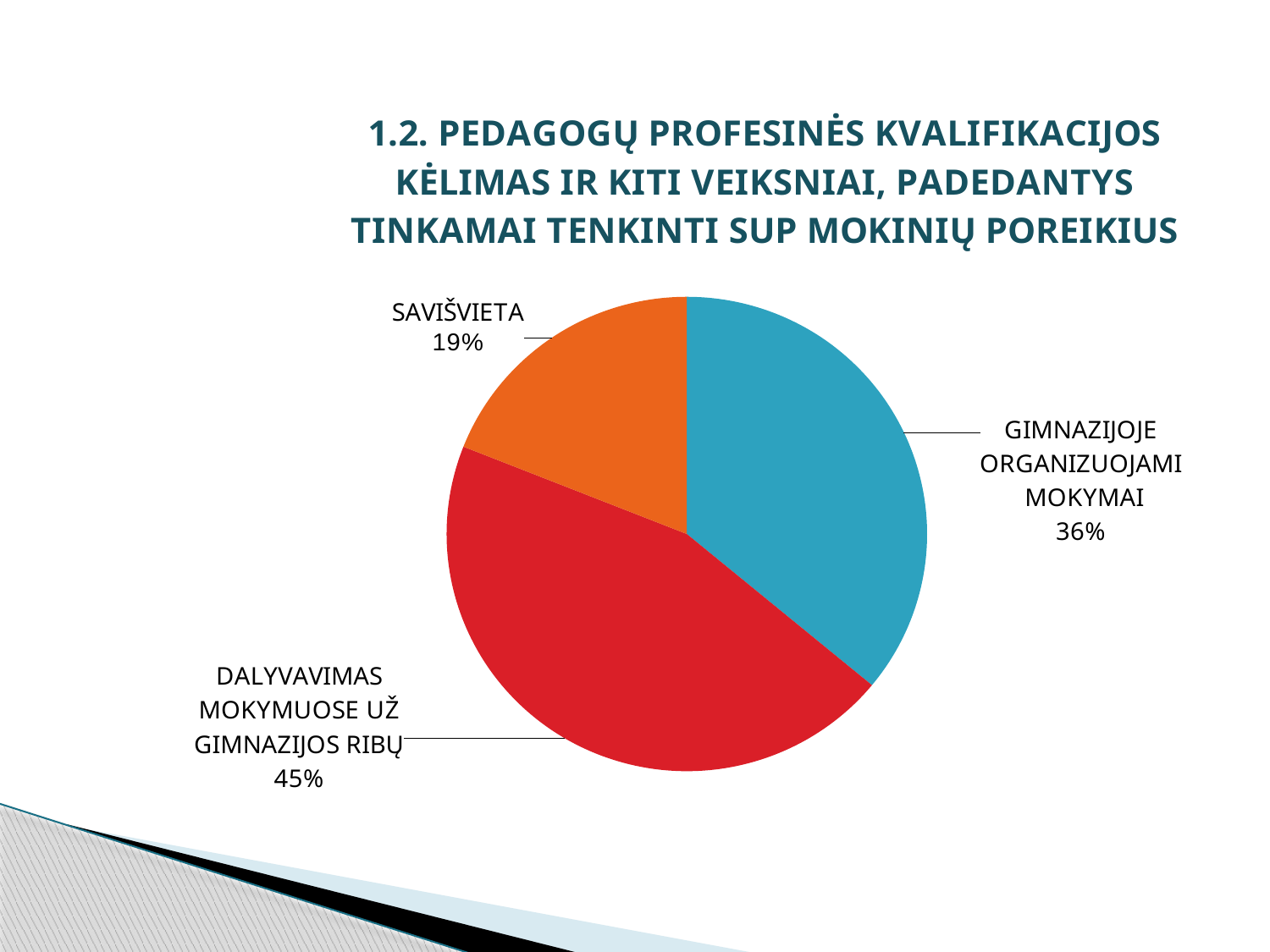
What share of the pie does SAVIŠVIETA represent? 19% Which category has the smallest slice of the pie? SAVIŠVIETA What colour is the slice for DALYVAVIMAS MOKYMUOSE UŽ GIMNAZIJOS RIBŲ? red What is the difference in percentage points between GIMNAZIJOJE ORGANIZUOJAMI MOKYMAI and SAVIŠVIETA? 17% What kind of chart is shown on the slide? pie chart Which category has the largest slice of the pie? DALYVAVIMAS MOKYMUOSE UŽ GIMNAZIJOS RIBŲ What colour is the slice for SAVIŠVIETA? orange What share of the pie does DALYVAVIMAS MOKYMUOSE UŽ GIMNAZIJOS RIBŲ represent? 45% What share of the pie does GIMNAZIJOJE ORGANIZUOJAMI MOKYMAI represent? 36% Which is larger, the share for GIMNAZIJOJE ORGANIZUOJAMI MOKYMAI or the share for SAVIŠVIETA? GIMNAZIJOJE ORGANIZUOJAMI MOKYMAI How many slices does the pie chart have? 3 What is the difference in percentage points between DALYVAVIMAS MOKYMUOSE UŽ GIMNAZIJOS RIBŲ and GIMNAZIJOJE ORGANIZUOJAMI MOKYMAI? 9%